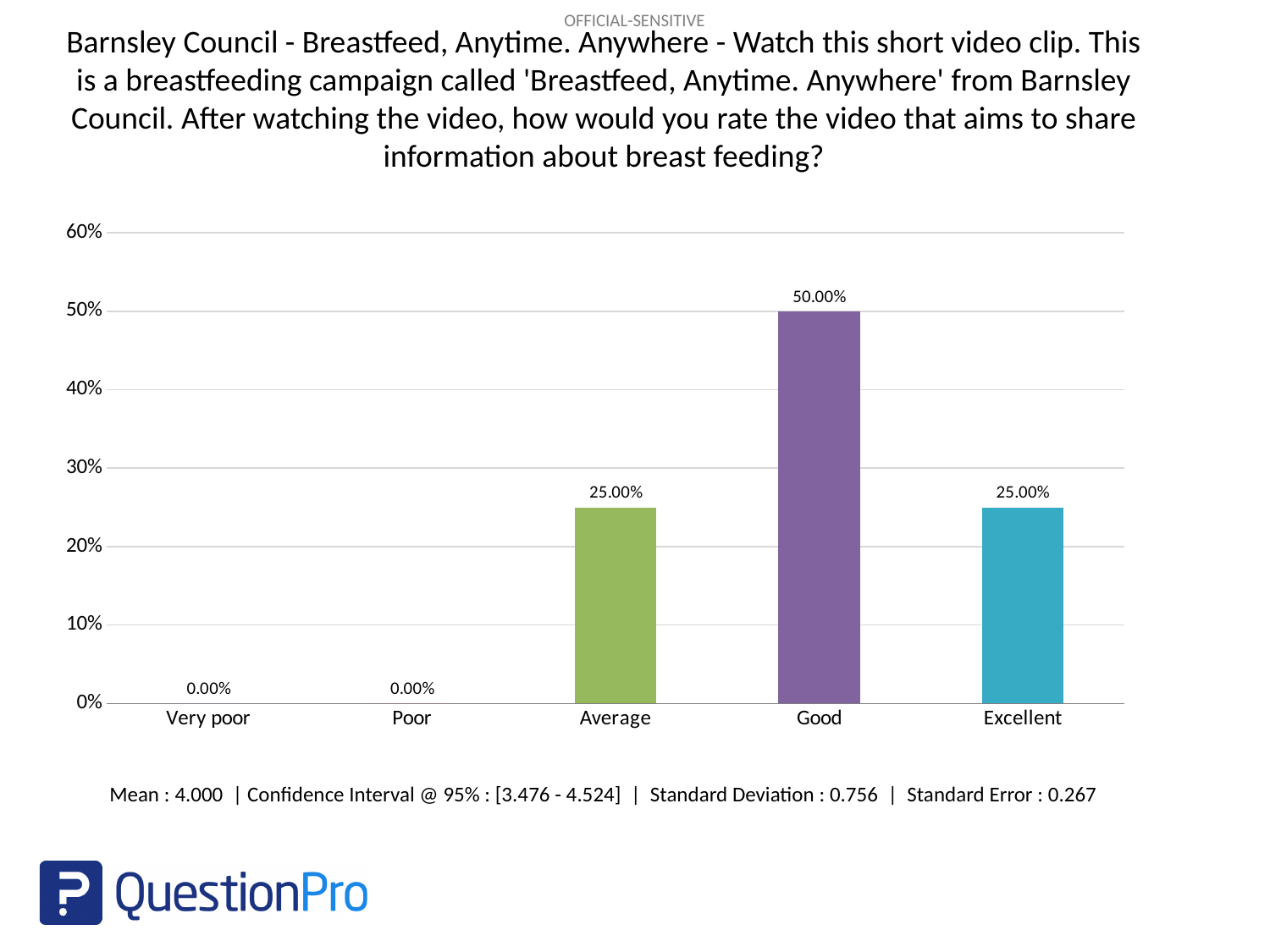
Is the value for Good greater or less than 40%? greater What is the value for Average? 25.00% Which is larger, the value for Good or the value for Average? Good What is the value for Good? 50.00% What is the difference between the values for Good and Excellent? 25.00% What is the value for Excellent? 25.00% How many categories are shown on the x axis? 5 What is the value for Very poor? 0.00% What kind of chart is shown on the slide? Bar chart Which category has the highest value? Good What is the mean value reported below the chart? 4.000 How many categories have a value of 0.00%? 2